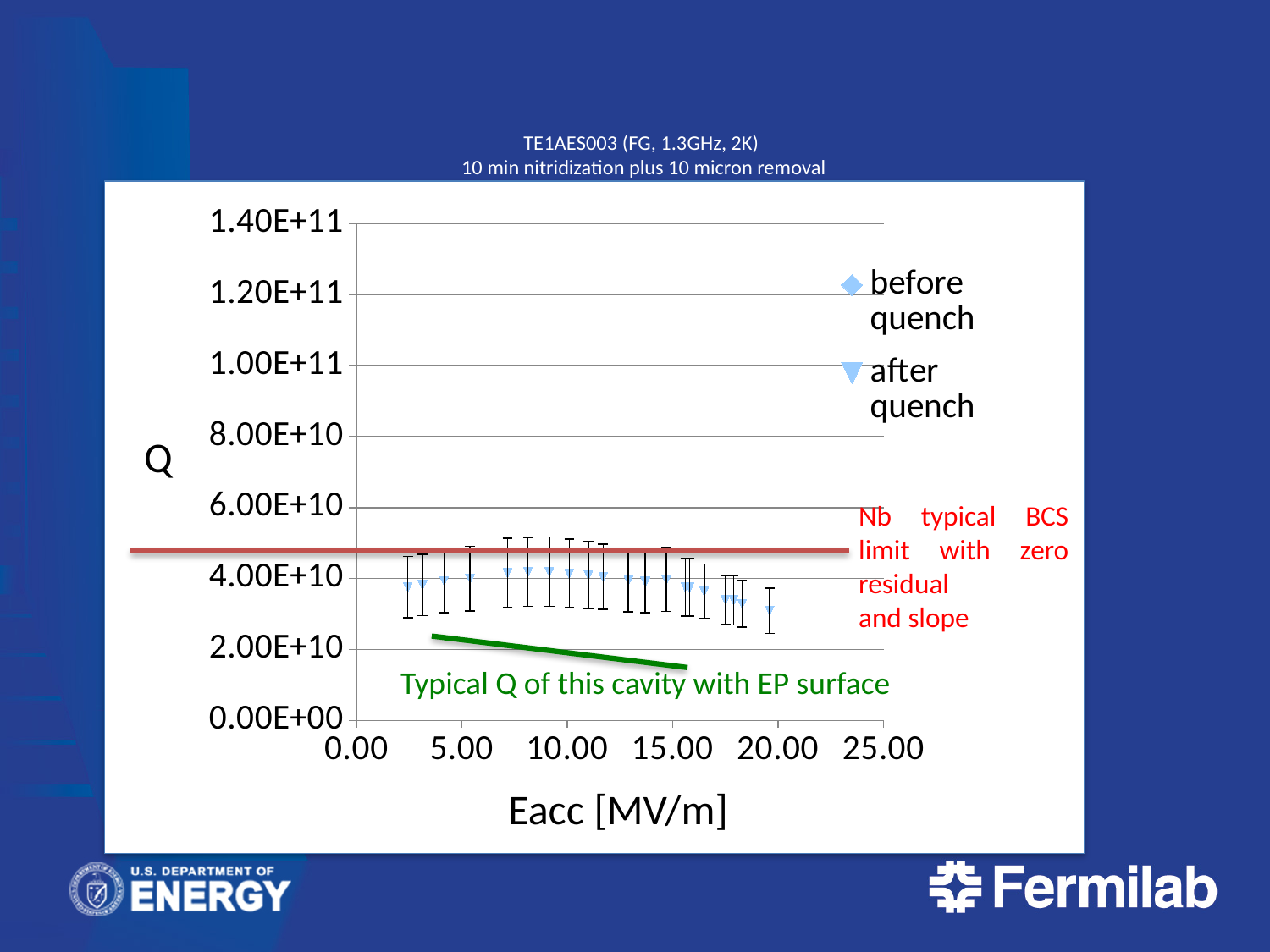
What are the two series named in the chart legend? before quench, after quench What kind of chart is shown on the slide? scatter chart Are the plotted Q values at Eacc around 10.00 MV/m greater or less than 2.00E+10? greater Is the plotted Q value at the highest Eacc point (near 20.00 MV/m) greater or less than 2.00E+10? greater How many series does the chart legend list? 2 What is the highest value shown on the y axis of the chart? 1.40E+11 Is the plotted Q value at Eacc around 5.00 MV/m greater or less than 8.00E+10? less Do the plotted Q values rise or fall as Eacc increases from about 15.00 to 20.00 MV/m? fall What is the label of the x axis of the chart? Eacc [MV/m]